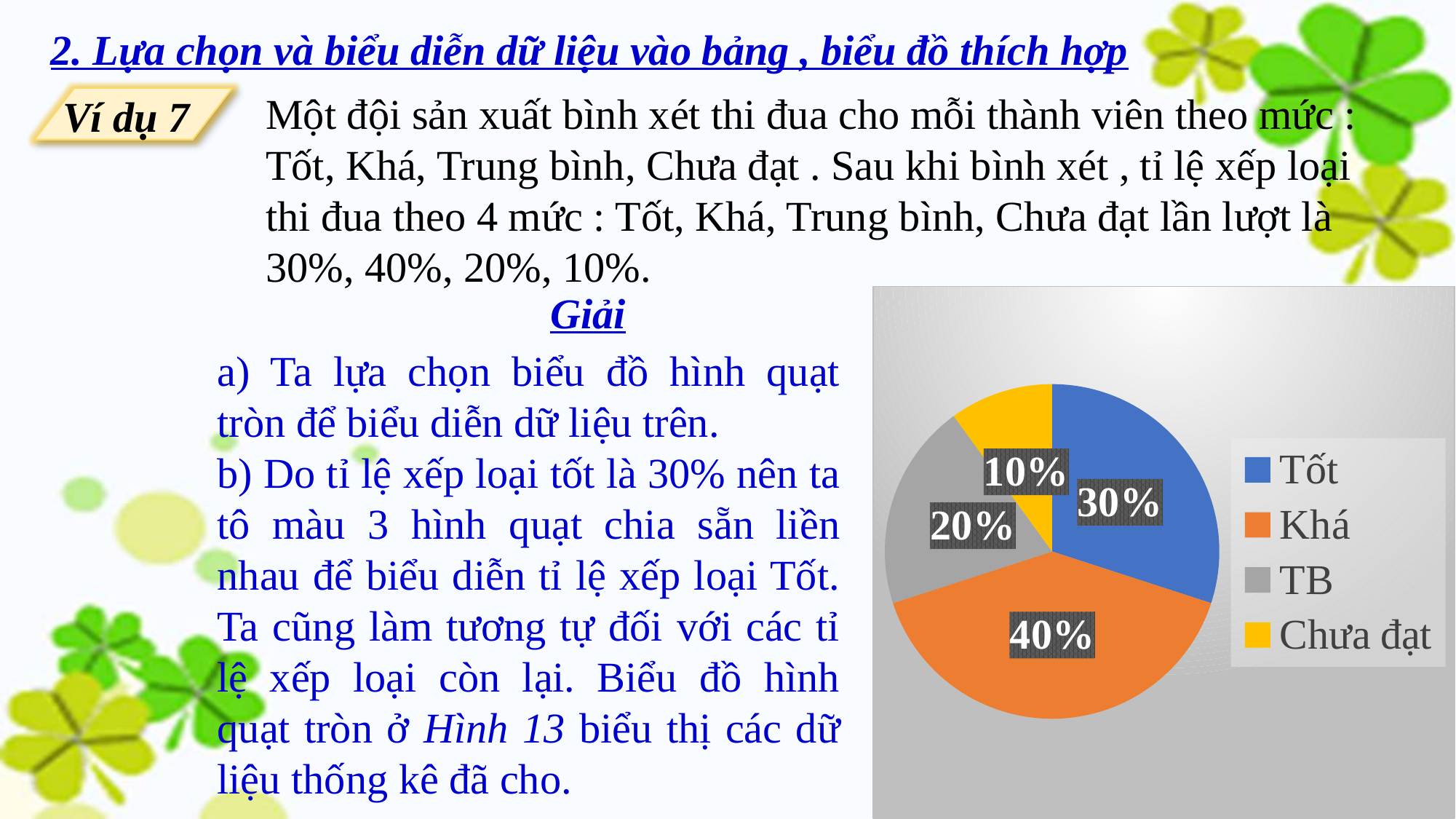
What kind of chart is shown on the slide? pie chart What colour is the Khá slice in the pie chart? orange Which category has the smallest slice of the pie? Chưa đạt What percentage does the Khá slice show? 40% What percentage does the Chưa đạt slice show? 10% What is the difference between the Khá and Tốt percentages? 10% What percentage does the TB slice show? 20% Which is larger, the TB slice or the Chưa đạt slice? TB What percentage does the Tốt slice show? 30% How many entries does the legend list? 4 Which category has the largest slice of the pie? Khá How many slices does the pie chart have? 4